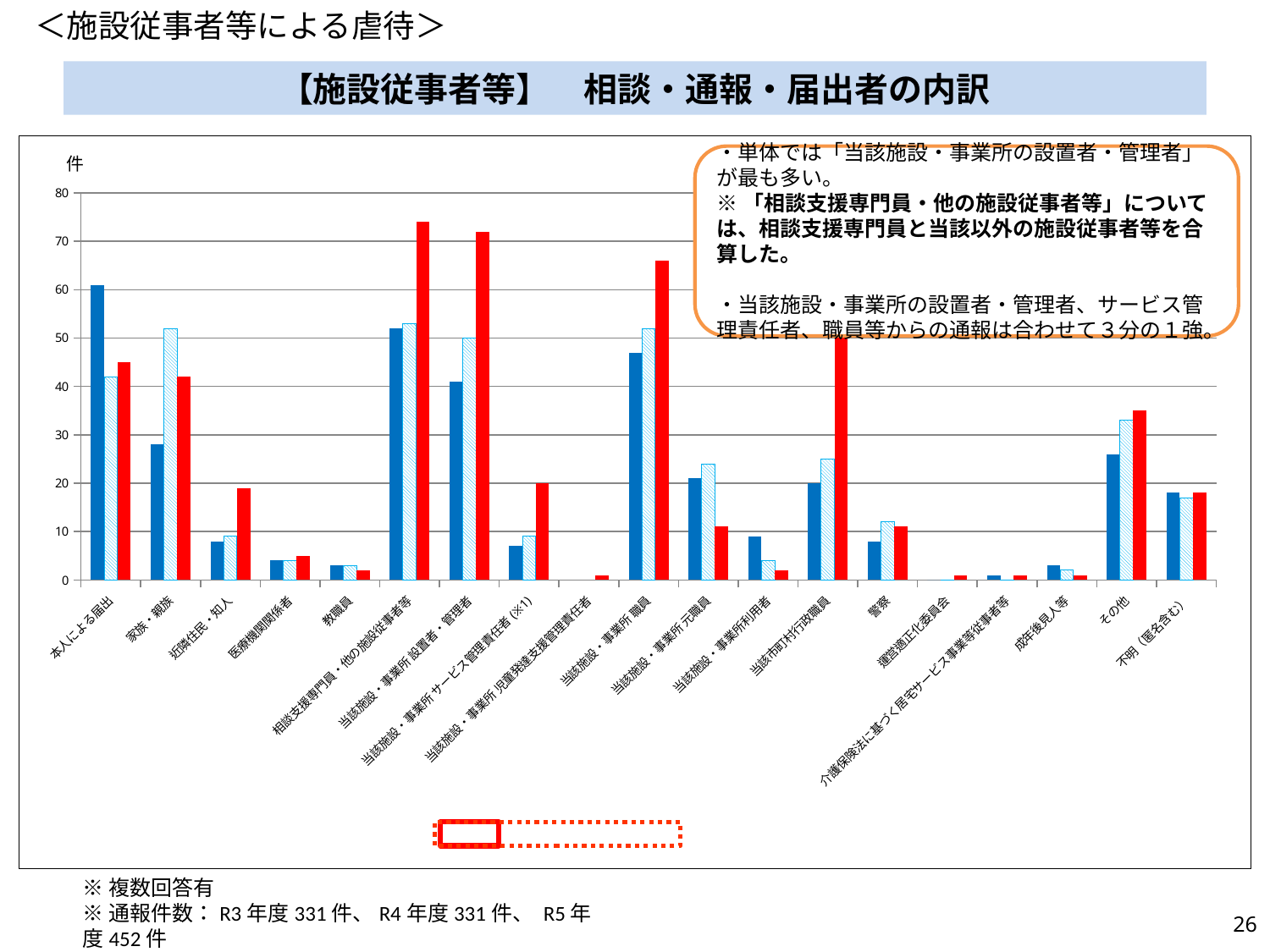
Is the red bar for 本人による届出 greater or less than 40? greater Is the red bar for 当該施設・事業所 職員 greater or less than 60? greater Is the dark blue bar for 家族・親族 greater or less than 20? greater Which category has the tallest dark blue bar? 本人による届出 What unit is shown at the top of the y axis? 件 How many categories are shown along the x axis of the chart? 19 For 本人による届出, which is larger: the dark blue bar or the red bar? the dark blue bar What kind of chart is shown on the slide? bar chart For 当該施設・事業所 元職員, which is larger: the light blue hatched bar or the red bar? the light blue hatched bar How many series (bars per category) are plotted in the chart? 3